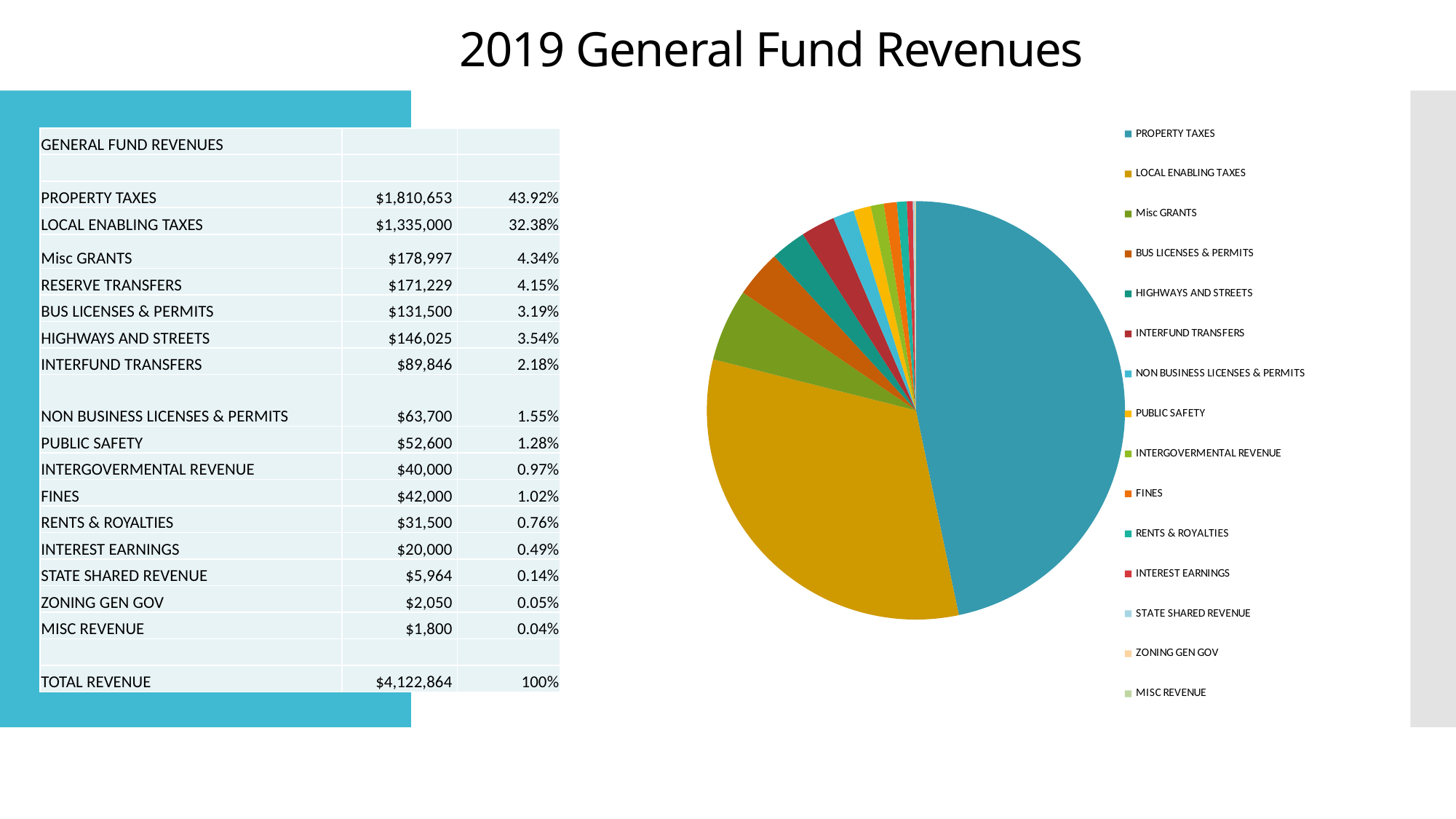
Which category has the largest slice in the pie chart? PROPERTY TAXES Which is larger in the pie chart, PROPERTY TAXES or LOCAL ENABLING TAXES? PROPERTY TAXES What kind of chart is shown on the slide? Pie chart According to the table, what is the revenue amount for PROPERTY TAXES? $1,810,653 According to the table, what is the revenue amount for LOCAL ENABLING TAXES? $1,335,000 Which is larger in the pie chart, Misc GRANTS or BUS LICENSES & PERMITS? Misc GRANTS What share of total revenue does PROPERTY TAXES represent, as shown in the table? 43.92% What is the TOTAL REVENUE shown in the table? $4,122,864 How many entries does the pie chart's legend list? 15 What is the difference between the PROPERTY TAXES and LOCAL ENABLING TAXES amounts shown in the table? $475,653 What share of total revenue does LOCAL ENABLING TAXES represent, as shown in the table? 32.38% According to the table, which revenue source has the smallest amount? MISC REVENUE